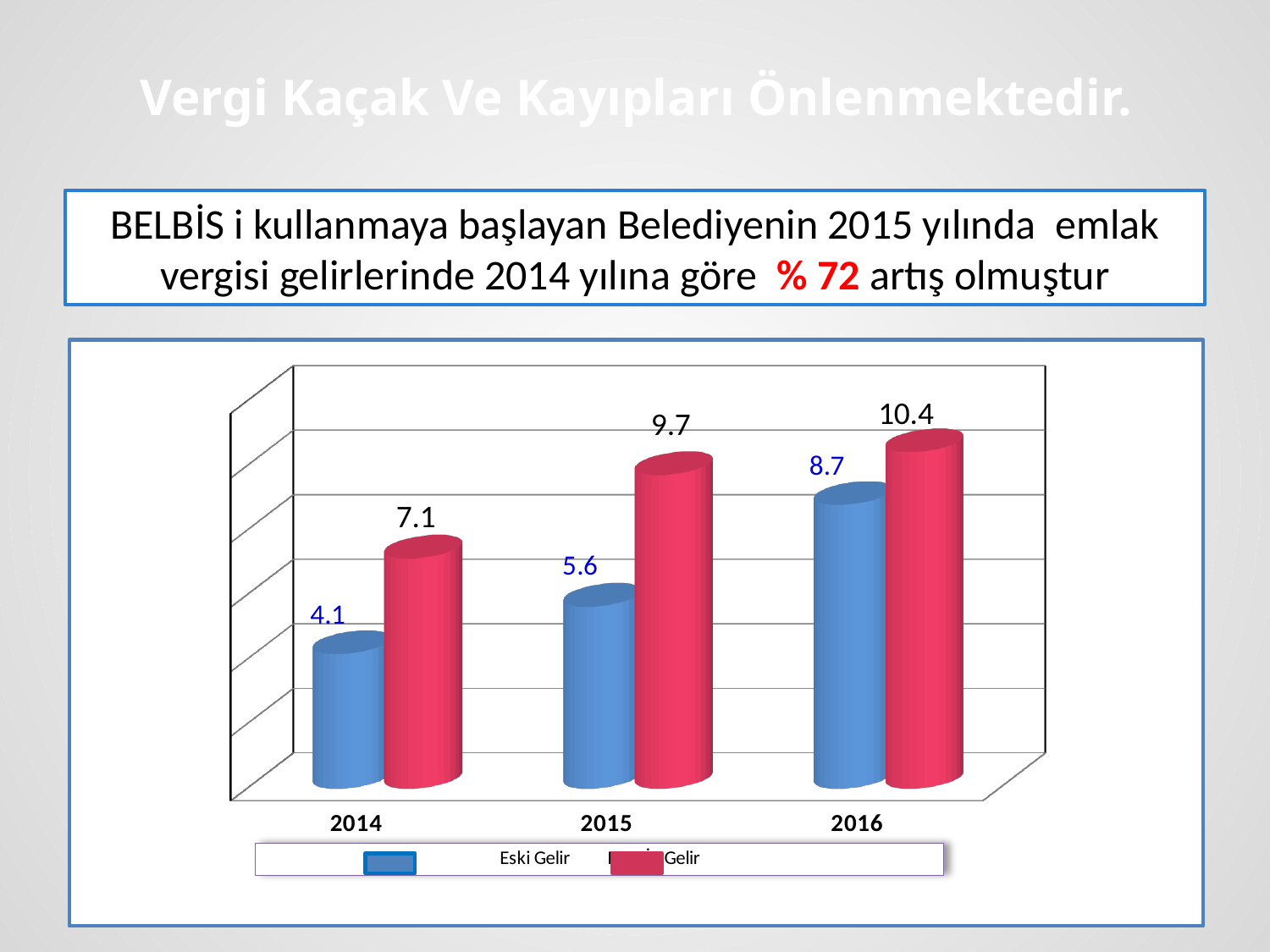
In which year is Eski Gelir highest? 2016 What is the value of Eski Gelir for 2014? 4.1 In which year is the red series lowest? 2014 What is the value of the red series for 2015? 9.7 What kind of chart is shown on the slide? bar chart How many series does the legend list? 2 What is the difference between the red series and Eski Gelir in 2015? 4.1 How many years are shown on the x axis? 3 Do the Eski Gelir values rise or fall from 2014 to 2016? rise Which is larger in 2014: Eski Gelir or the red series? the red series What is the value of the red series for 2016? 10.4 What is the value of Eski Gelir for 2016? 8.7